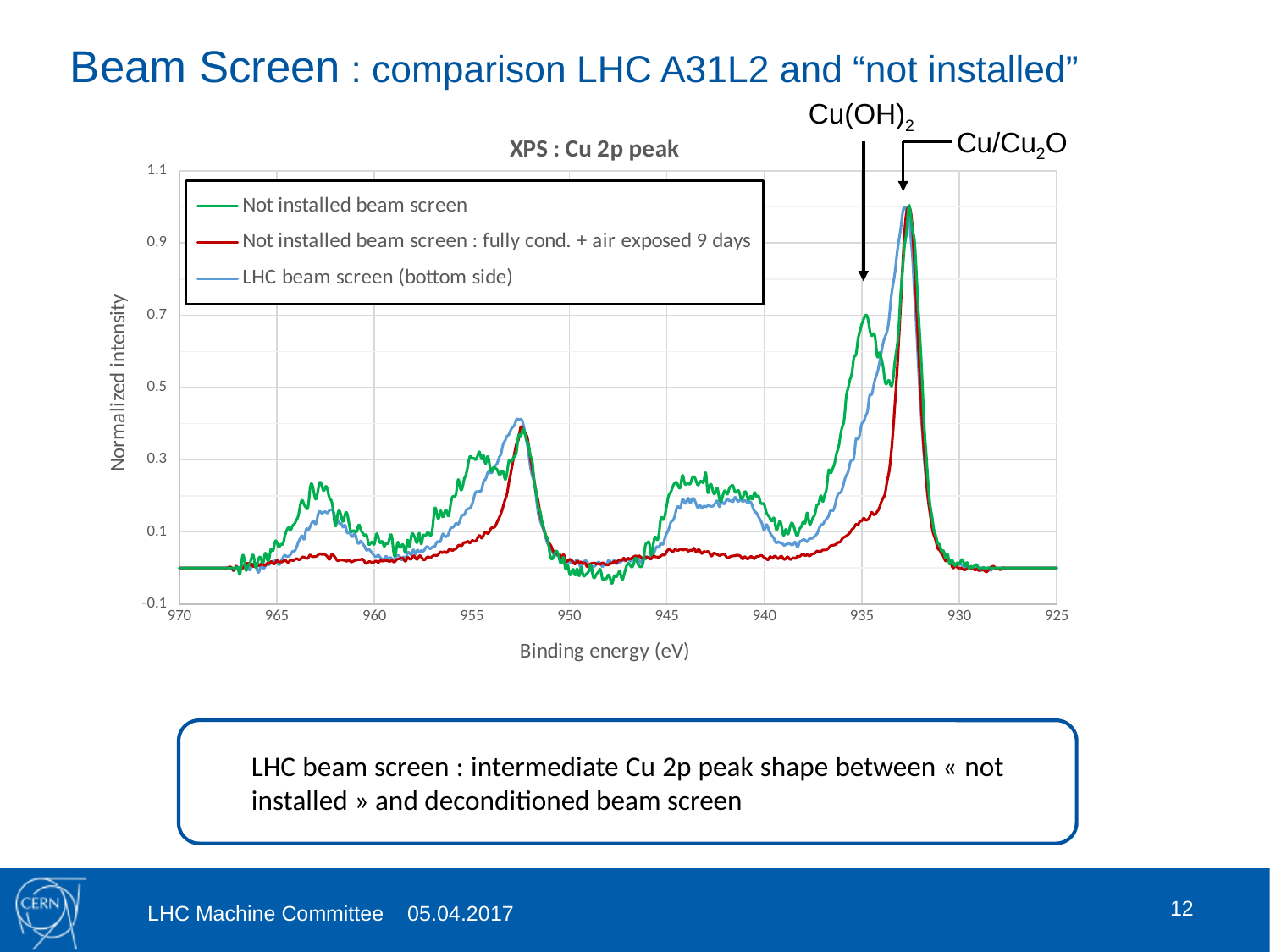
What kind of chart is shown on the slide? line chart Is the value of the 'Not installed beam screen : fully cond. + air exposed 9 days' line at 963 eV greater or less than 0.1? less Which chemical species is annotated at the peak near 935 eV? Cu(OH)2 At 963 eV, which line is higher: 'Not installed beam screen' or 'LHC beam screen (bottom side)'? Not installed beam screen Is the value of the 'Not installed beam screen' line at its main peak near 932.5 eV greater or less than 0.9? greater What is the title of the chart? XPS : Cu 2p peak Is the value of the 'Not installed beam screen : fully cond. + air exposed 9 days' line at 935 eV greater or less than 0.3? less Which series has the lowest value at 943 eV? Not installed beam screen : fully cond. + air exposed 9 days How many series does the legend list? 3 At 935 eV, which line is higher: 'Not installed beam screen' or 'Not installed beam screen : fully cond. + air exposed 9 days'? Not installed beam screen